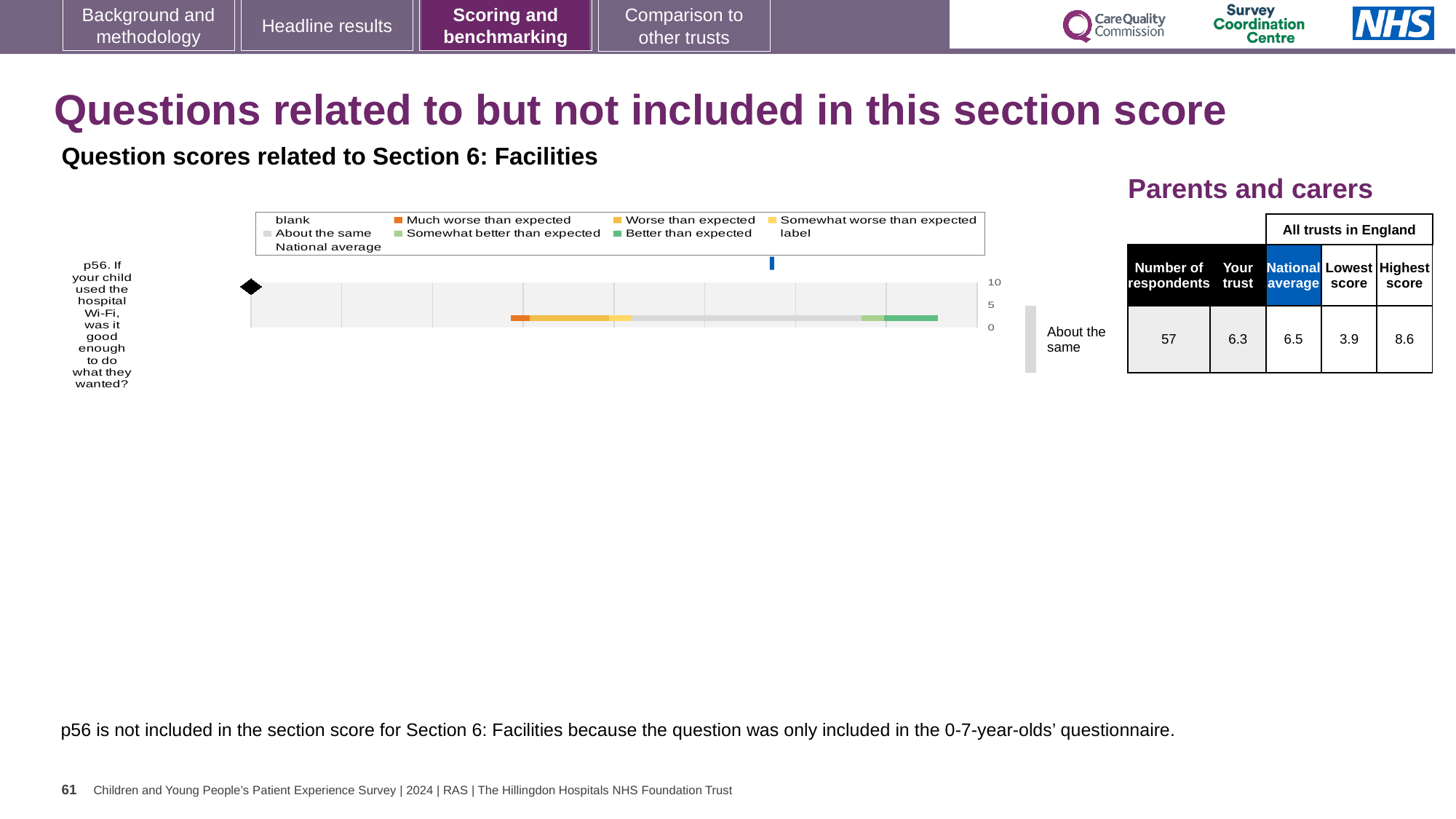
What is the highest score among all trusts in England for p56? 8.6 What benchmarking category is the trust's result for p56 placed in? About the same Which question number is plotted in the chart? p56 What is the lowest score among all trusts in England for p56? 3.9 What is the number of respondents for p56? 57 Which respondent group does the chart relate to? Parents and carers Which is larger for p56, the 'Your trust' score or the national average? National average What is the national average score for p56? 6.5 What is the 'Your trust' score for p56? 6.3 How many questions are plotted in the chart? 1 What is the difference between the highest score and the lowest score for p56? 4.7 What kind of chart is shown on the slide? bar chart